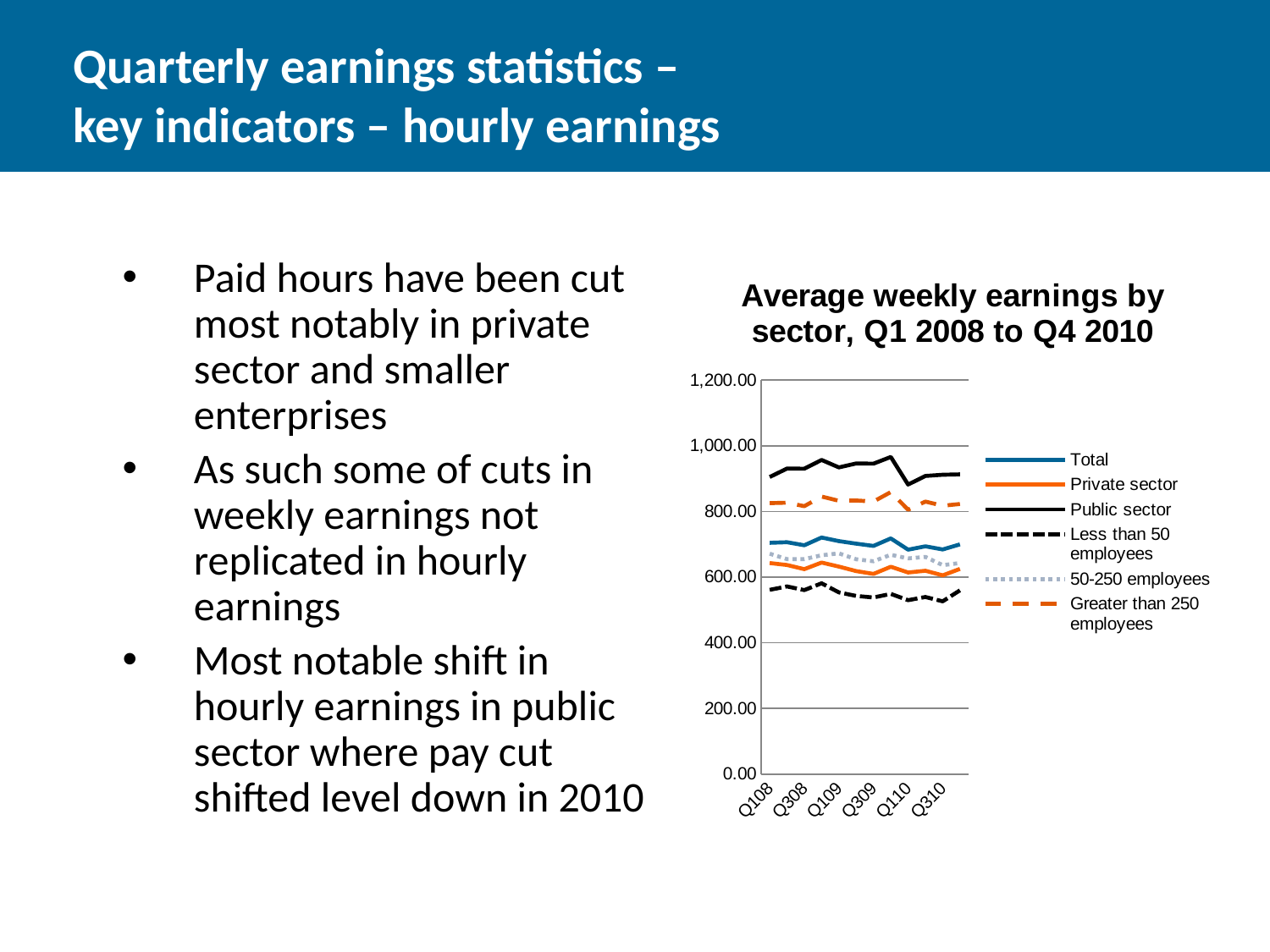
How many quarter labels are shown on the x axis of the chart? 6 How many series does the legend of the chart list? 6 Which series has the highest values across the chart? Public sector Is the value for Public sector at Q108 greater or less than 800? greater Is the value for Less than 50 employees at Q310 greater or less than 600? less Is the value for Total at Q108 greater or less than 600? greater What is the title of the chart? Average weekly earnings by sector, Q1 2008 to Q4 2010 What kind of chart is shown on the slide? line chart At Q109, which is larger: Public sector or Private sector? Public sector Which series has the lowest values across the chart? Less than 50 employees